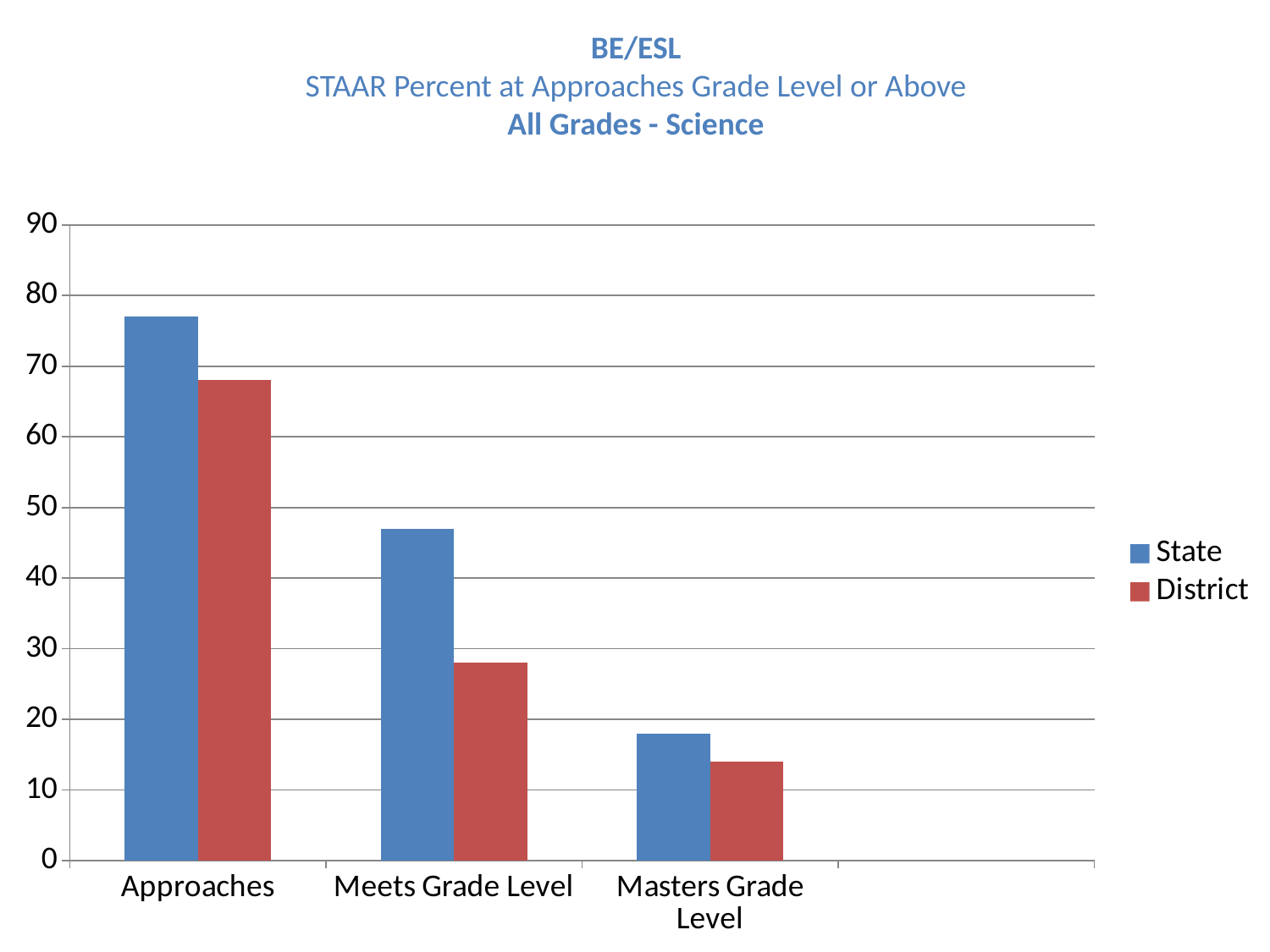
Is the District value for Masters Grade Level greater or less than 10? greater Do the State values rise or fall moving from Approaches to Masters Grade Level? fall Which category has the lowest District value? Masters Grade Level What kind of chart is shown on the slide? bar chart How many series does the legend list? 2 Is the State value for Approaches greater or less than 70? greater Is the District value for Approaches greater or less than 60? greater How many categories are shown on the x axis? 3 Which category has the highest State value? Approaches For Meets Grade Level, which is larger, the State value or the District value? State Which series is shown in red? District